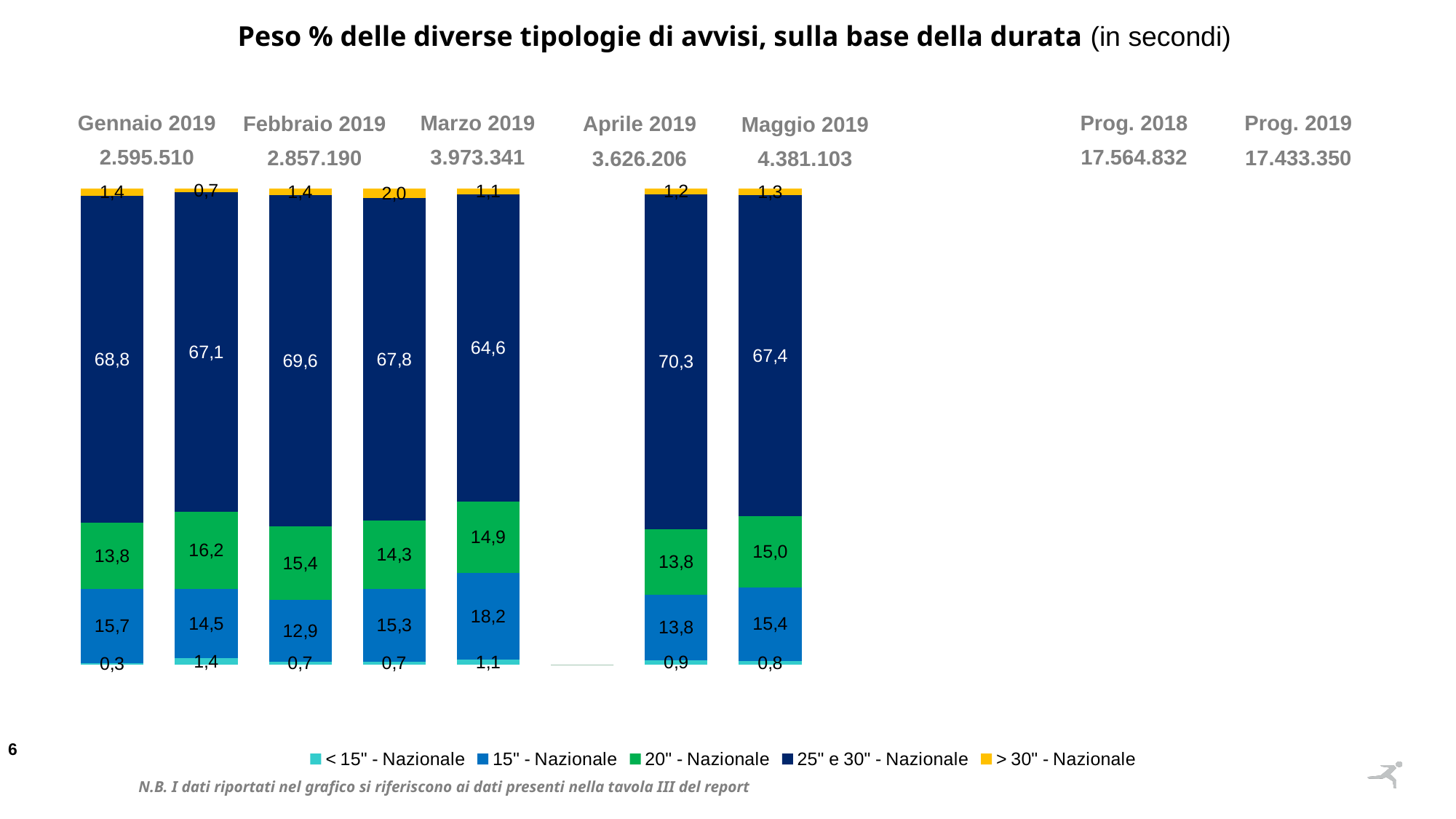
Which series is shown in yellow in the legend? > 30" - Nazionale Which bar has the lowest value for the '25" e 30" - Nazionale' series? The fifth bar from the left (64,6) How many series does the legend list? 5 What is the difference between the '25" e 30" - Nazionale' values in the sixth bar (70,3) and the fifth bar (64,6)? 5,7 Which bar has the highest value for the '15" - Nazionale' series? The fifth bar from the left (18,2) What is the value of the '15" - Nazionale' segment in the rightmost bar? 15,4 Which bar has the highest value for the '25" e 30" - Nazionale' series? The sixth bar from the left (70,3) What is the value of the '25" e 30" - Nazionale' segment in the leftmost bar? 68,8 In the leftmost bar, which is larger: the '15" - Nazionale' segment or the '20" - Nazionale' segment? 15" - Nazionale (15,7) What is the value of the '> 30" - Nazionale' segment in the fourth bar from the left? 2,0 What kind of chart is shown on the slide? Stacked bar chart What is the value of the '20" - Nazionale' segment in the second bar from the left? 16,2